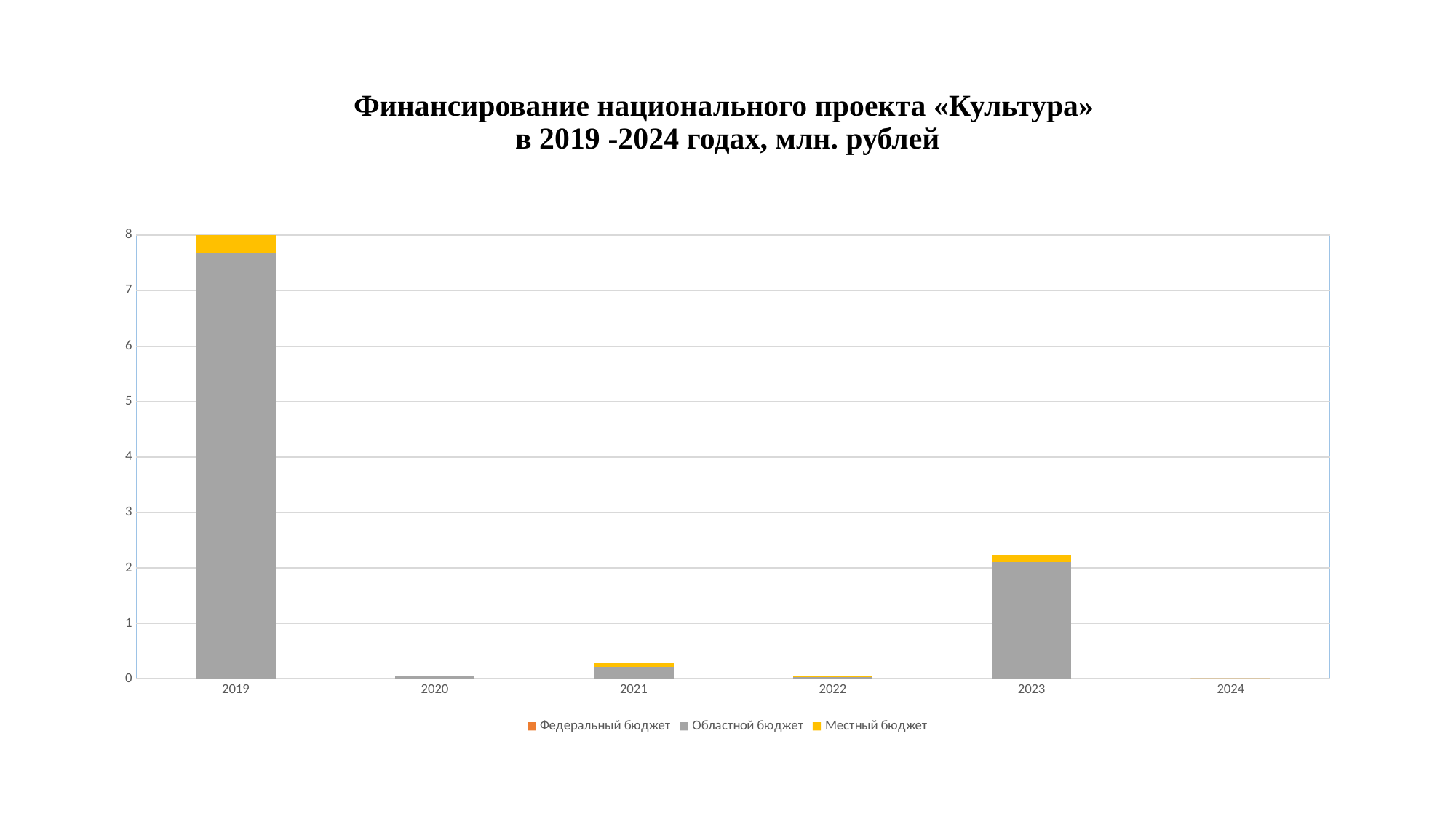
Which year has the larger total funding, 2021 or 2023? 2023 Which colour represents Местный бюджет in the legend? yellow How many series does the legend list? 3 Which year has the larger total funding, 2019 or 2023? 2019 Does the total funding rise or fall from 2019 to 2020? fall What kind of chart is shown on the slide? bar chart How many years (categories) are shown on the x axis? 6 Is the total value for 2019 greater or less than 7? greater Which year has the highest total funding? 2019 Is the total value for 2023 greater or less than 2? greater Which year has the lowest total funding? 2024 Is the total value for 2021 greater or less than 1? less